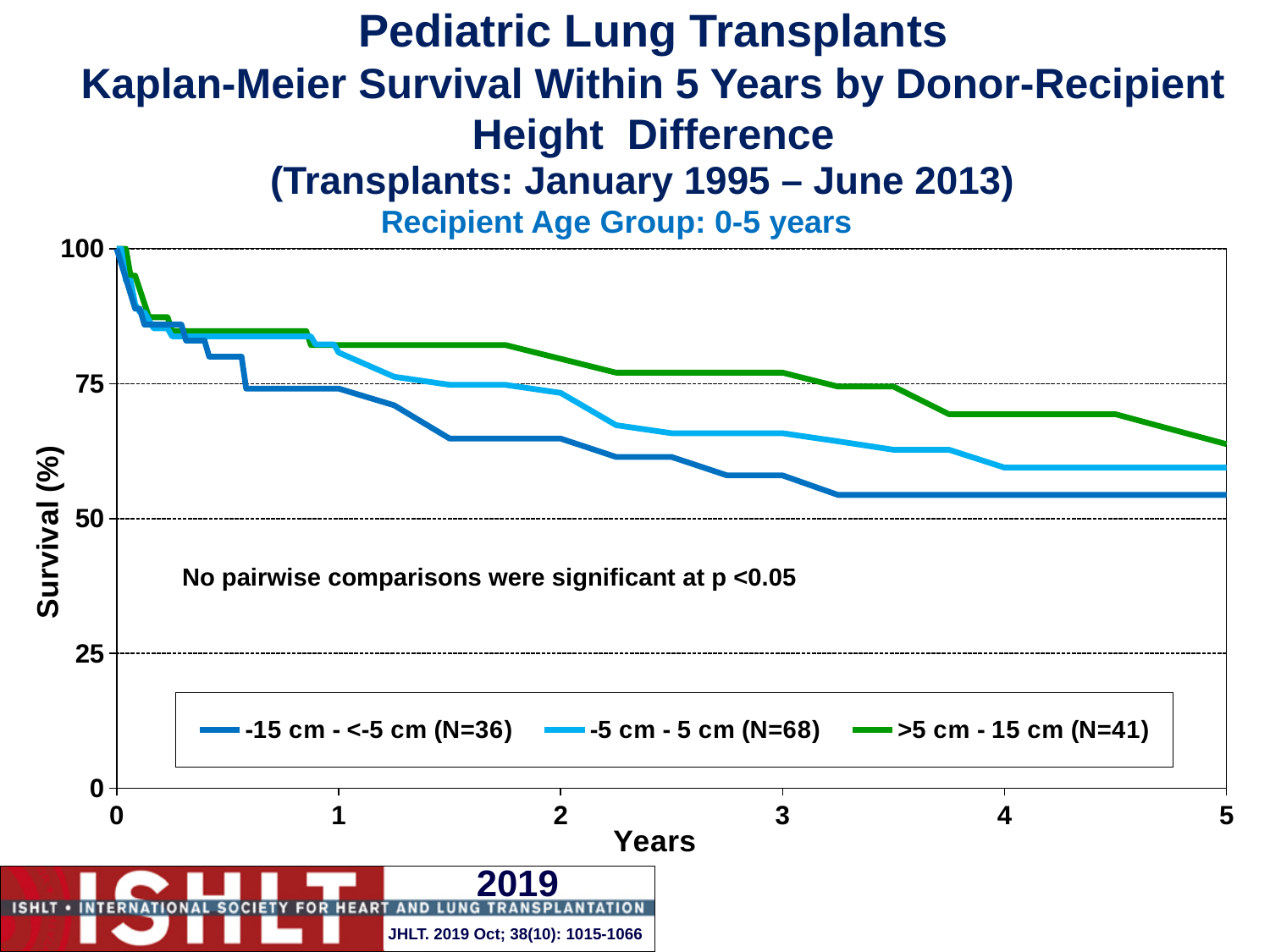
At 5 years, which has higher survival: the >5 cm - 15 cm group or the -15 cm - <-5 cm group? >5 cm - 15 cm group What is the maximum value shown on the Years axis? 5 Which group has the highest survival at 5 years? >5 cm - 15 cm (N=41) Is the survival for the >5 cm - 15 cm group at 2 years greater or less than 75? greater Is the survival for the -15 cm - <-5 cm group at 2 years greater or less than 75? less Which recipient age group does the chart cover? 0-5 years What is the N for the -5 cm - 5 cm group in the legend? 68 Do the survival curves rise or fall as years increase? Fall Which group has the lowest survival at 5 years? -15 cm - <-5 cm (N=36) How many series does the legend list? 3 Is the survival for the >5 cm - 15 cm group at 5 years greater or less than 50? greater What kind of chart is shown on the slide? Line chart